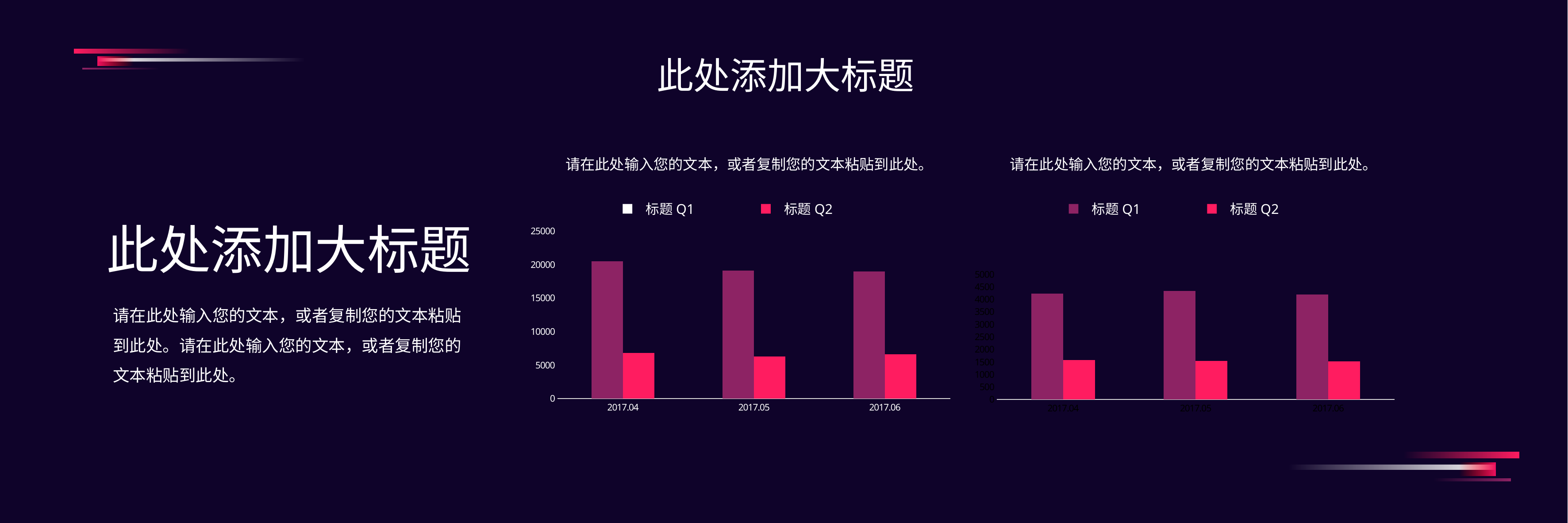
In the left chart, is the value for 标题 Q1 in 2017.04 greater or less than 15000? greater In the left chart, is the value for 标题 Q2 in 2017.05 greater or less than 10000? less In the left chart, is the value for 标题 Q2 in 2017.04 greater or less than 5000? greater In the right chart, how many groups of bars are shown? 3 In the left chart, what are the two legend entries? 标题 Q1 and 标题 Q2 In the left chart, which category has the highest value for 标题 Q1? 2017.04 In the left chart, what kind of chart is shown? bar chart In the left chart, how many series does the legend list? 2 In the left chart, which is larger in 2017.06, 标题 Q1 or 标题 Q2? 标题 Q1 In the right chart, how many series does the legend list? 2 In the left chart, how many categories are shown on the x axis? 3